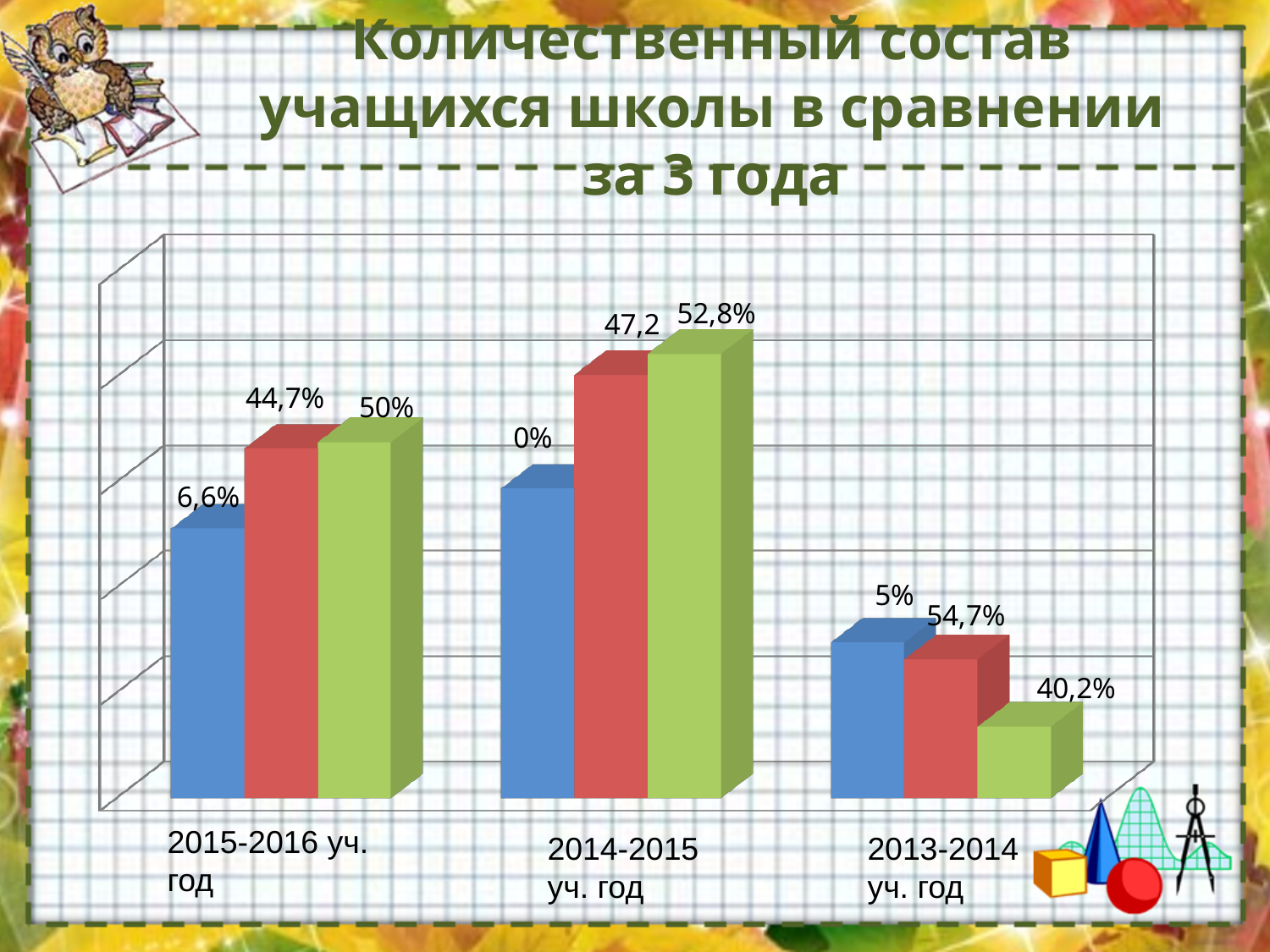
What is the data label on the red bar for 2013-2014 уч. год? 54,7% For 2015-2016 уч. год, which is larger: the red bar or the green bar? the green bar What kind of chart is shown on the slide? bar chart What is the data label on the red bar for 2014-2015 уч. год? 47,2 What is the title of the chart on the slide? Количественный состав учащихся школы в сравнении за 3 года What is the data label on the green bar for 2014-2015 уч. год? 52,8% What is the data label on the green bar for 2013-2014 уч. год? 40,2% What is the data label on the blue bar for 2015-2016 уч. год? 6,6% What is the data label on the green bar for 2015-2016 уч. год? 50% What is the difference between the green bar (50%) and the red bar (44,7%) for 2015-2016 уч. год? 5,3% For 2013-2014 уч. год, which is larger: the red bar or the green bar? the red bar How many school-year categories are shown on the x axis? 3